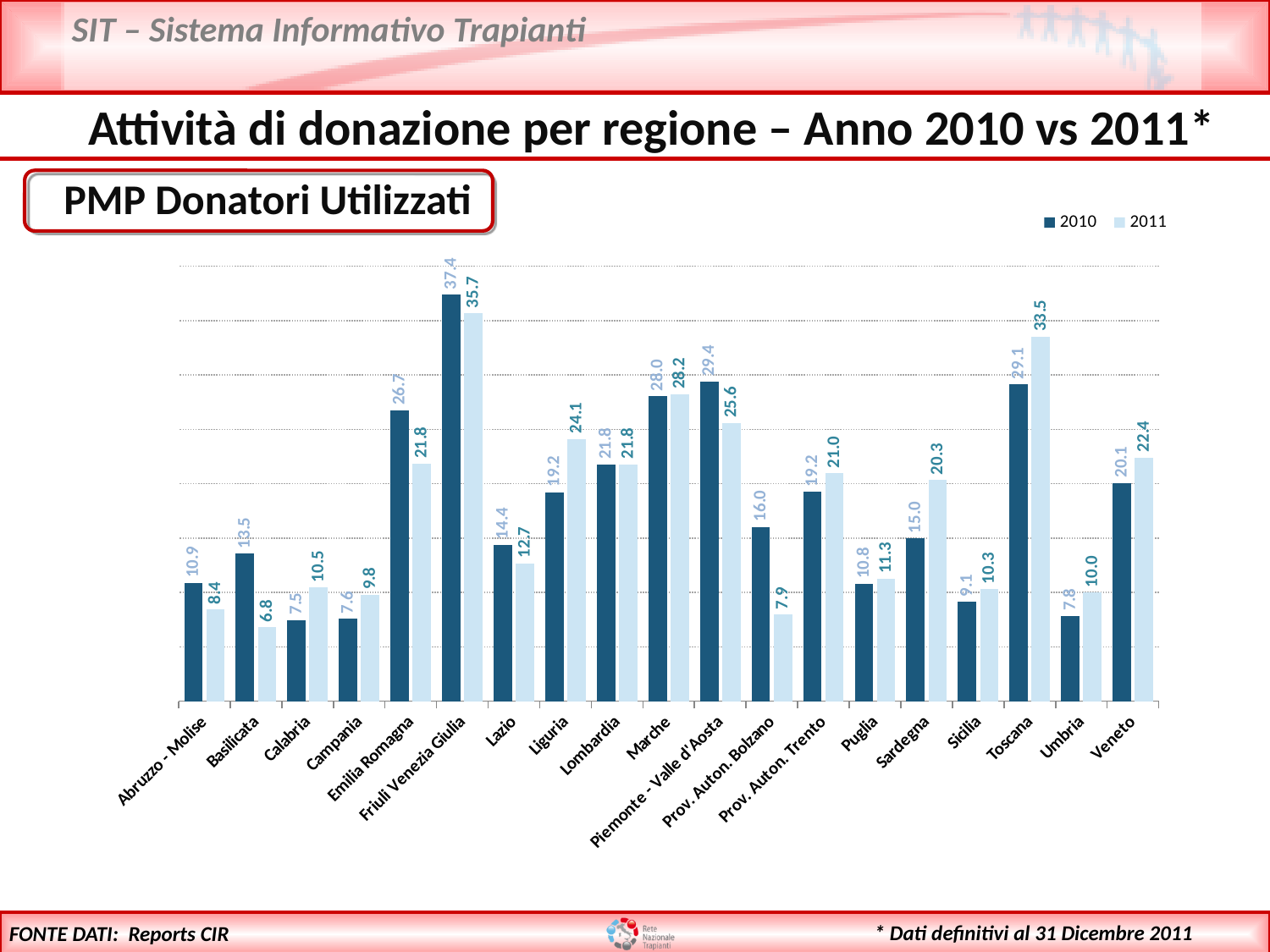
What is the 2010 value for Friuli Venezia Giulia? 37.4 Which is larger for Sardegna, the 2010 value or the 2011 value? 2011 Which region has the highest 2010 value? Friuli Venezia Giulia What is the 2011 value for Toscana? 33.5 How many regions (categories) are shown on the x axis? 19 How many series does the legend list? 2 What is the title shown in the box above the chart? PMP Donatori Utilizzati What type of chart is shown on the slide? bar chart Which region has the lowest 2011 value? Basilicata What is the difference between the 2010 and 2011 values for Prov. Auton. Bolzano? 8.1 What is the 2011 value for Prov. Auton. Bolzano? 7.9 What is the difference between the 2010 and 2011 values for Basilicata? 6.7